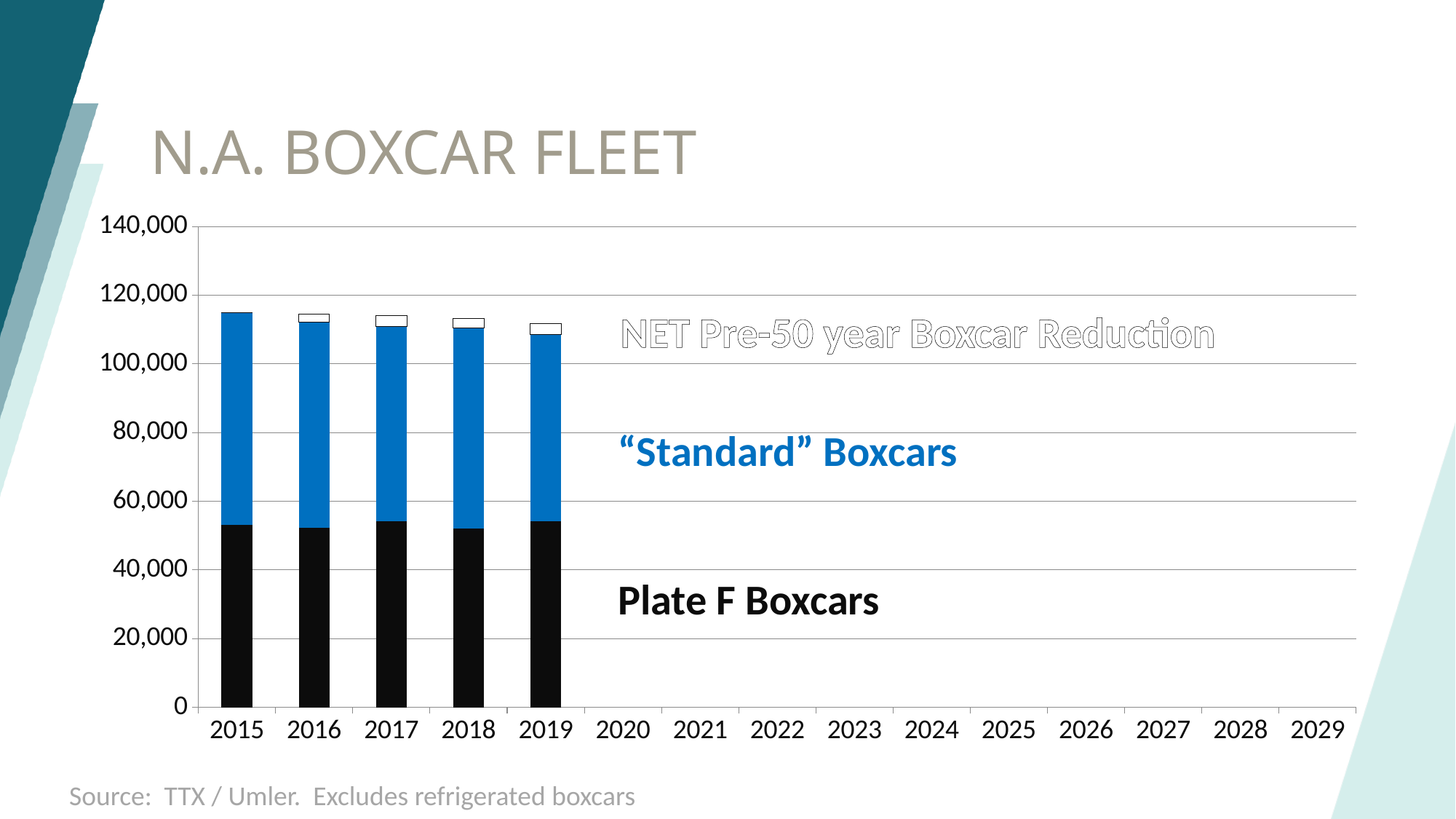
What is the title of the slide? N.A. BOXCAR FLEET In 2015, which segment is larger: Plate F Boxcars or "Standard" Boxcars? "Standard" Boxcars Is the total height of the 2015 bar greater or less than 120,000? less Is the value for Plate F Boxcars in 2017 greater or less than 60,000? less Which series is shown in black? Plate F Boxcars Is the top of the "Standard" Boxcars segment in 2019 greater or less than 100,000? greater How many series are labelled on the chart? 3 How many years are labelled on the x axis? 15 What kind of chart is shown on the slide? Stacked bar chart Does the top of the "Standard" Boxcars segment rise or fall from 2015 to 2019? fall How many years on the x axis have bars plotted? 5